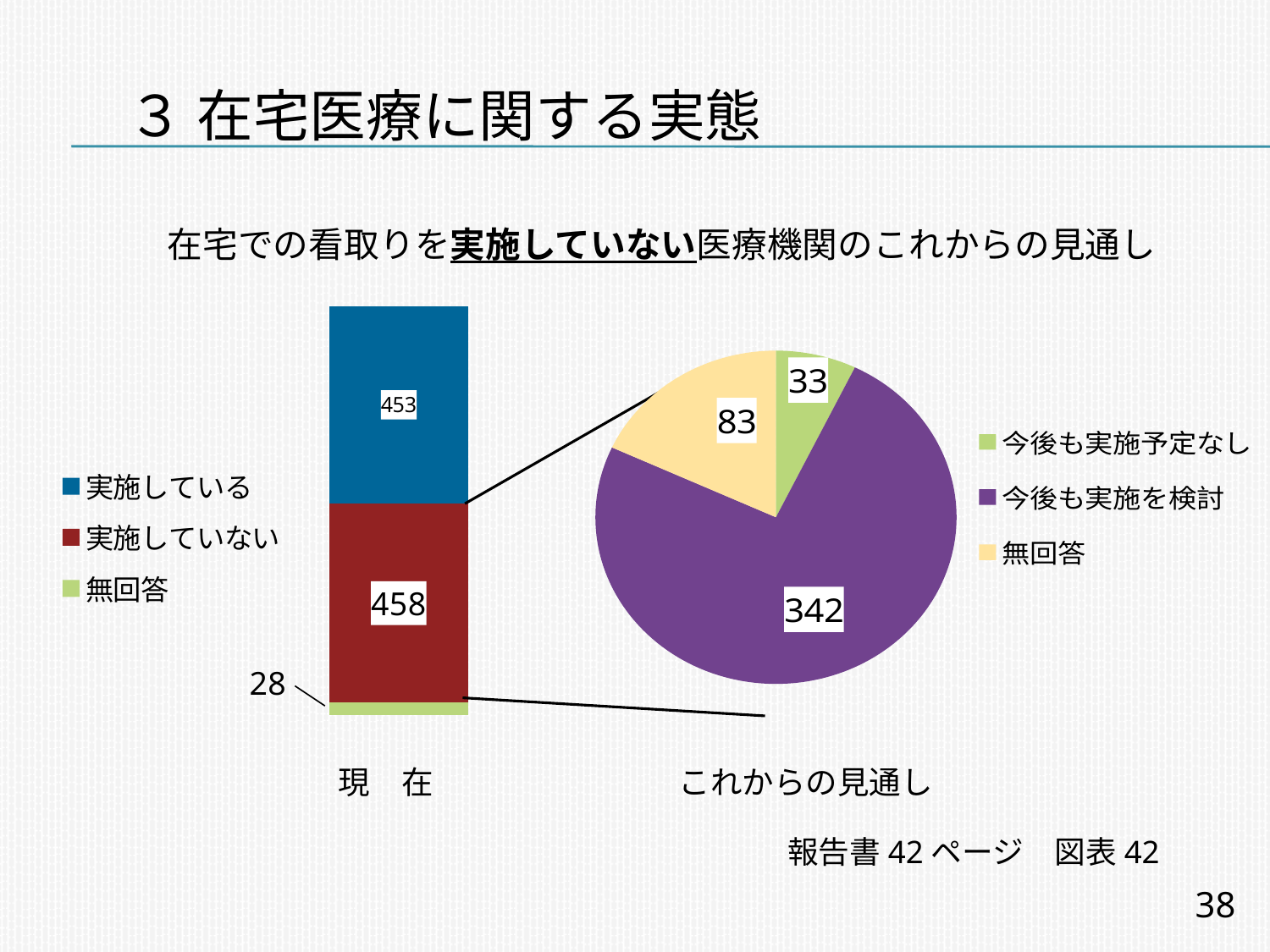
In the pie chart on the right (これからの見通し), what is the value for 今後も実施を検討? 342 In the pie chart on the right (これからの見通し), what is the difference between 無回答 and 今後も実施予定なし? 50 In the stacked bar chart on the left (現在), what is the value for 無回答? 28 In the pie chart on the right (これからの見通し), which category has the largest value? 今後も実施を検討 In the stacked bar chart on the left (現在), what is the value for 実施している? 453 What kind of chart is the chart on the right (これからの見通し)? pie chart In the stacked bar chart on the left (現在), what is the value for 実施していない? 458 In the pie chart on the right (これからの見通し), which category has the smallest value? 今後も実施予定なし In the stacked bar chart on the left (現在), what is the difference between 実施していない and 実施している? 5 In the stacked bar chart on the left (現在), how many series does the legend list? 3 In the stacked bar chart on the left (現在), what is the total of the bar? 939 In the pie chart on the right (これからの見通し), what is the value for 無回答? 83